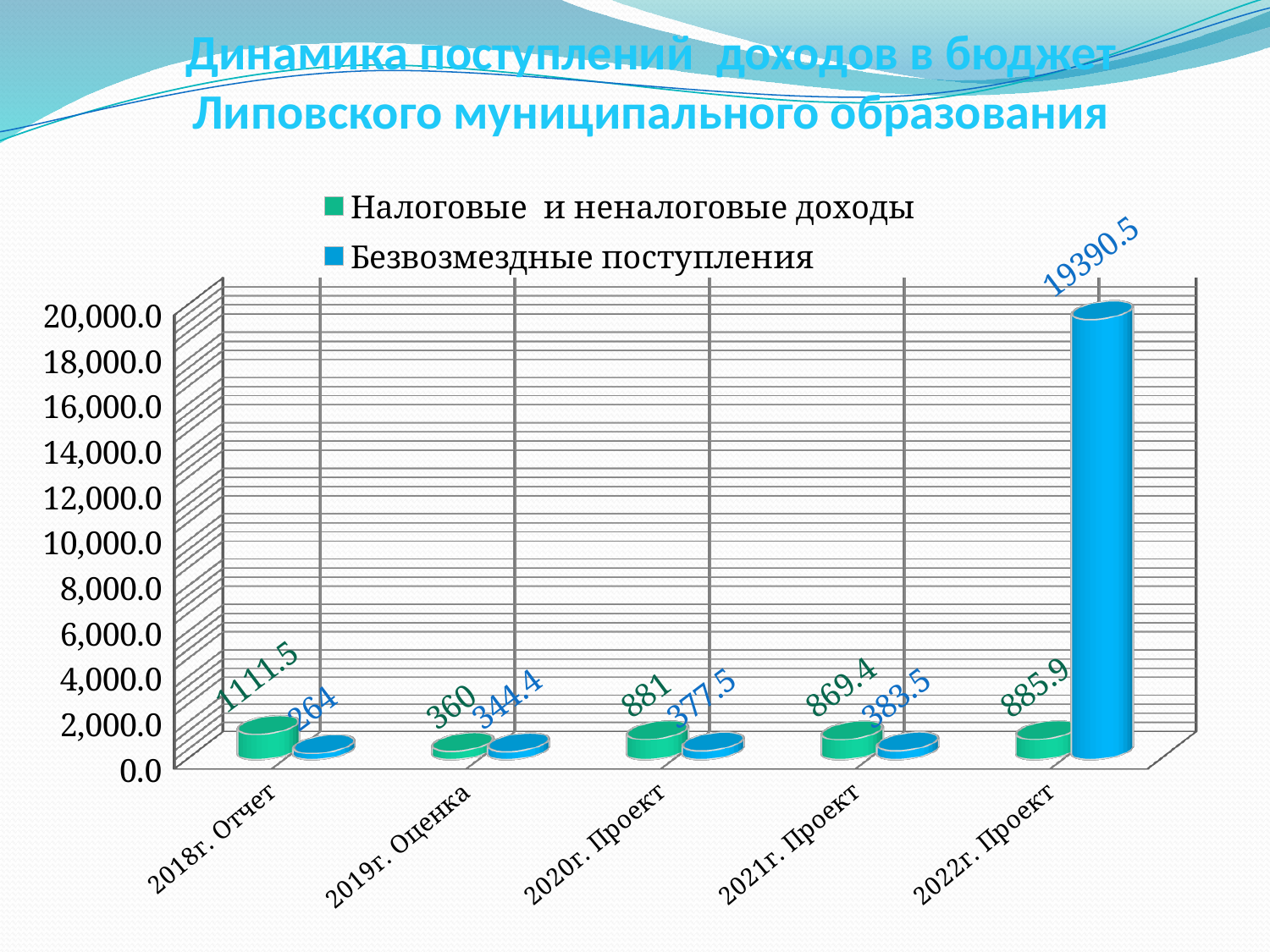
What is the difference between Налоговые и неналоговые доходы and Безвозмездные поступления for 2018г. Отчет? 847.5 What kind of chart is shown on the slide? Bar chart Is the value of Безвозмездные поступления for 2022г. Проект greater or less than 18,000.0? greater What is the value of Безвозмездные поступления for 2022г. Проект? 19390.5 Which category has the highest value for Безвозмездные поступления? 2022г. Проект What is the value of Налоговые и неналоговые доходы for 2021г. Проект? 869.4 What is the value of Налоговые и неналоговые доходы for 2018г. Отчет? 1111.5 How many categories are shown on the x axis? 5 Which is larger for 2019г. Оценка: Налоговые и неналоговые доходы or Безвозмездные поступления? Налоговые и неналоговые доходы How many series does the legend list? 2 Which category has the lowest value for Налоговые и неналоговые доходы? 2019г. Оценка What is the value of Безвозмездные поступления for 2020г. Проект? 377.5